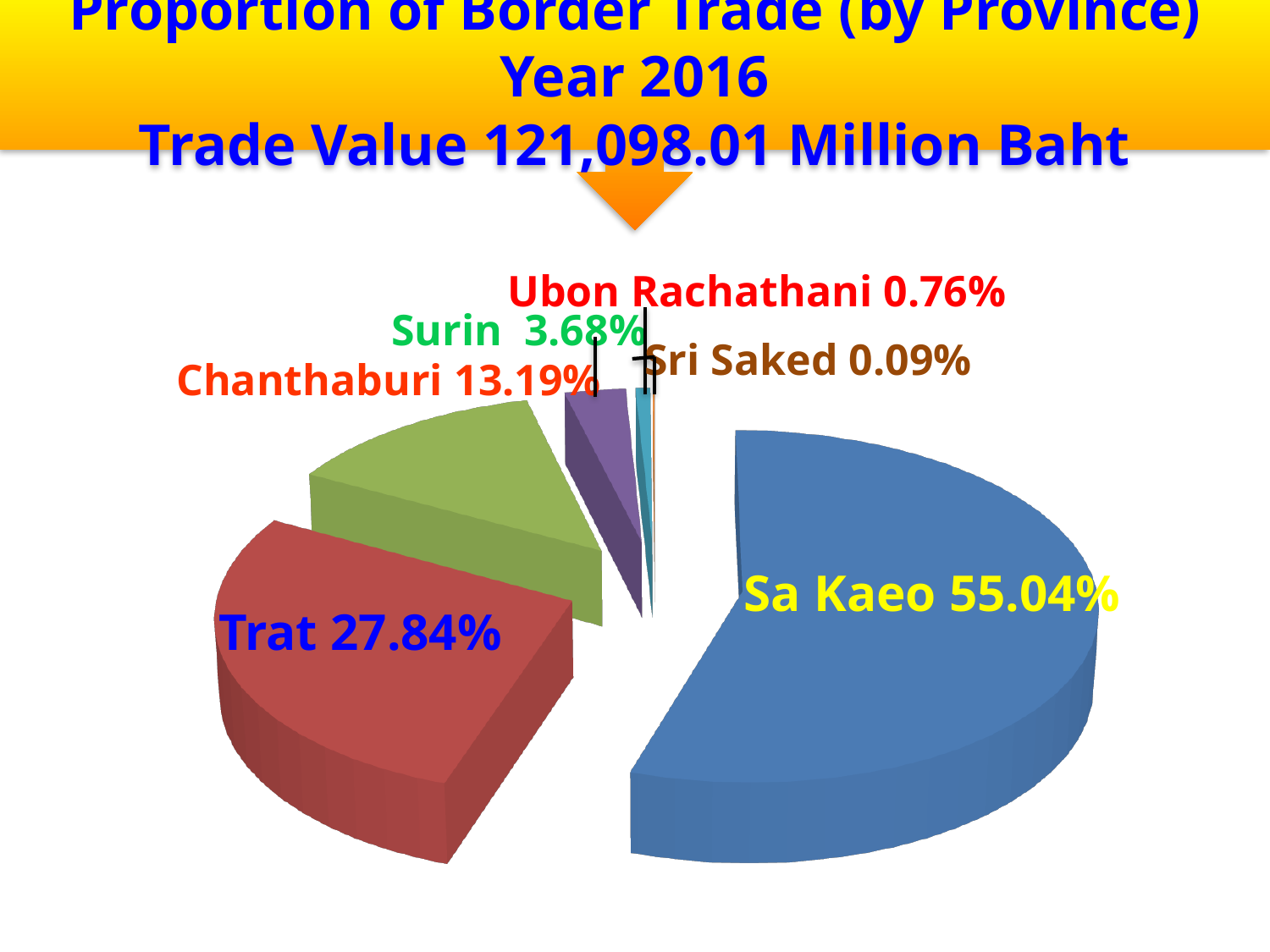
Which province has the largest share of border trade? Sa Kaeo How many provinces are shown in the pie chart? 6 What type of chart is shown on the slide? Pie chart What is the percentage shown for Trat? 27.84% What total trade value is stated in the chart title? 121,098.01 Million Baht What is the percentage shown for Chanthaburi? 13.19% Which has a larger share, Chanthaburi or Surin? Chanthaburi What is the percentage shown for Ubon Rachathani? 0.76% What share of border trade does Sa Kaeo account for? 55.04% What is the percentage shown for Surin? 3.68% Which province has the smallest share of border trade? Sri Saked What is the difference in percentage points between Sa Kaeo and Trat? 27.20